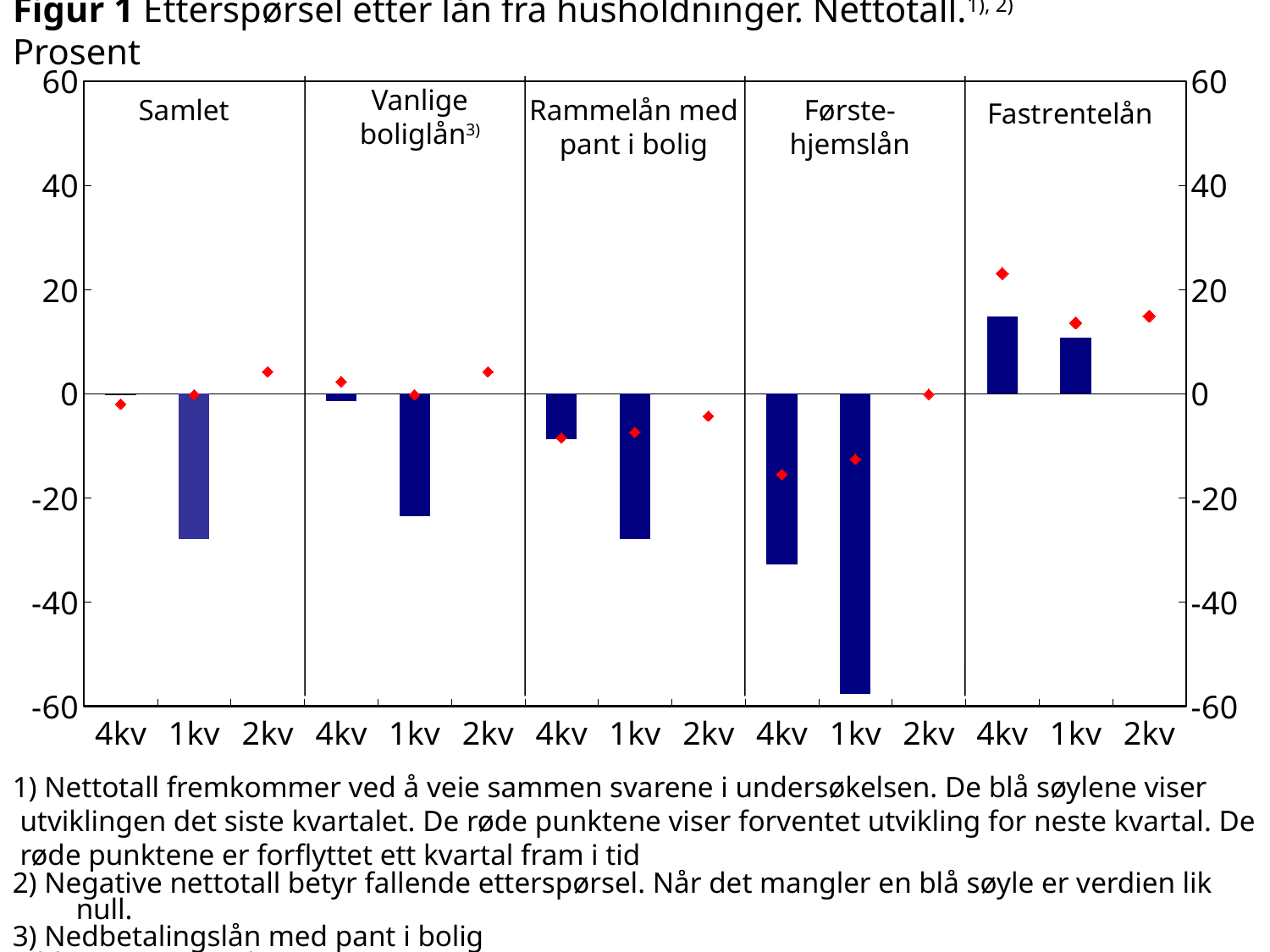
Which loan category has the lowest (most negative) bar in 1kv? Førstehjemslån Is the bar value for Førstehjemslån in 4kv greater or less than -20? less Is the bar value for Førstehjemslån in 1kv greater or less than -40? less For Fastrentelån, do the bars rise or fall from 4kv to 1kv? fall Which loan category has the highest bar in 4kv? Fastrentelån Which is lower, the 1kv bar for Førstehjemslån or the 1kv bar for Samlet? Førstehjemslån Is the bar value for Rammelån med pant i bolig in 1kv greater or less than -20? less What kind of chart is shown on the slide? bar chart According to the footnote, what do the red points in the chart show? Forventet utvikling for neste kvartal How many loan categories (panels) does the chart show? 5